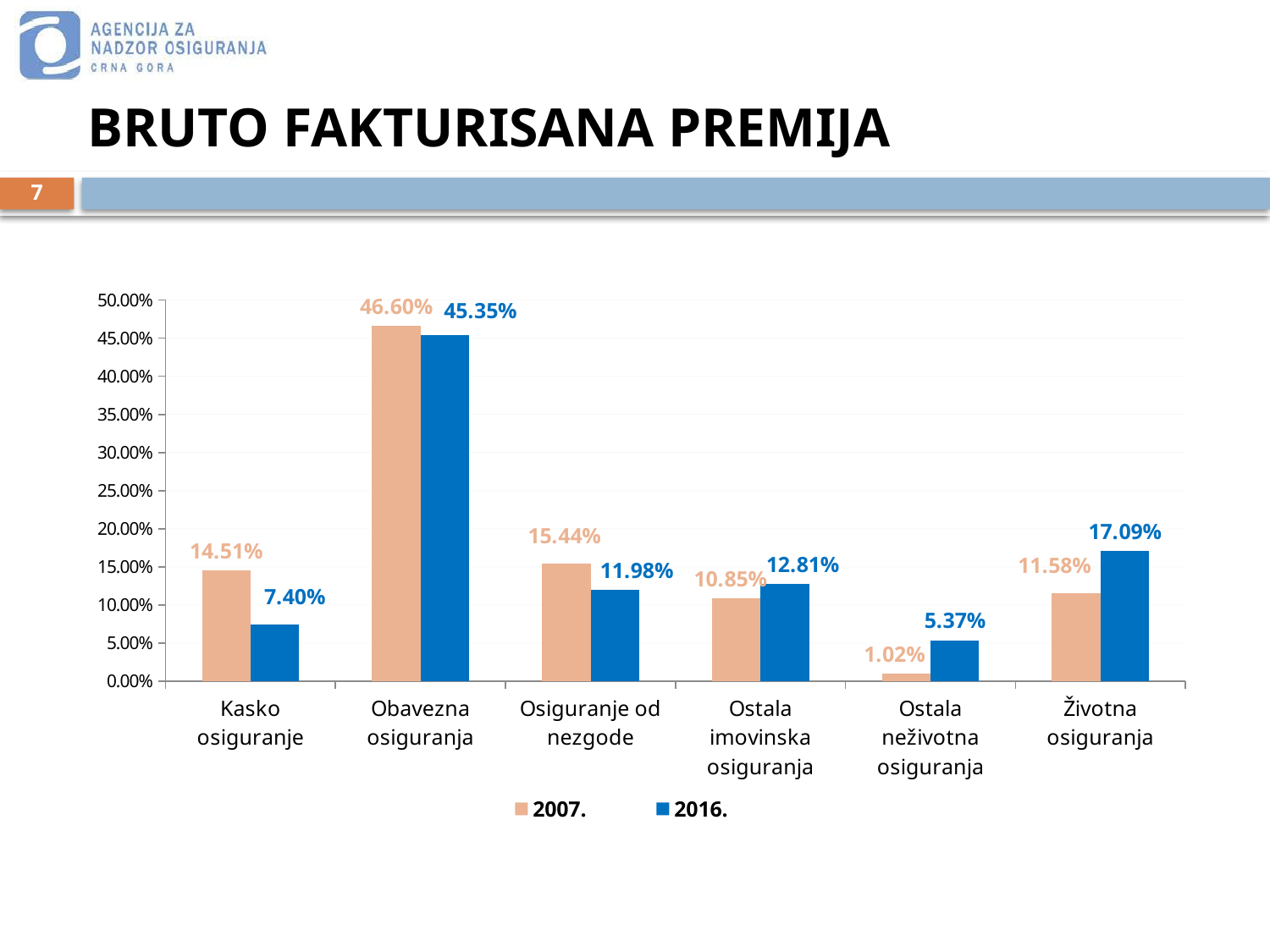
Which is larger for Ostala imovinska osiguranja: the 2007. value or the 2016. value? 2016. What is the difference between the 2007. and 2016. values for Kasko osiguranje? 7.11% What kind of chart is shown on the slide? bar chart Which category has the lowest 2007. value? Ostala neživotna osiguranja What is the 2007. value for Kasko osiguranje? 14.51% What are the two series named in the legend? 2007. and 2016. What is the 2016. value for Ostala neživotna osiguranja? 5.37% Which category has the highest 2016. value? Obavezna osiguranja Is the 2007. value for Osiguranje od nezgode greater or less than 15.00%? greater How many categories are shown on the x axis? 6 How many series does the legend list? 2 What is the 2016. value for Životna osiguranja? 17.09%